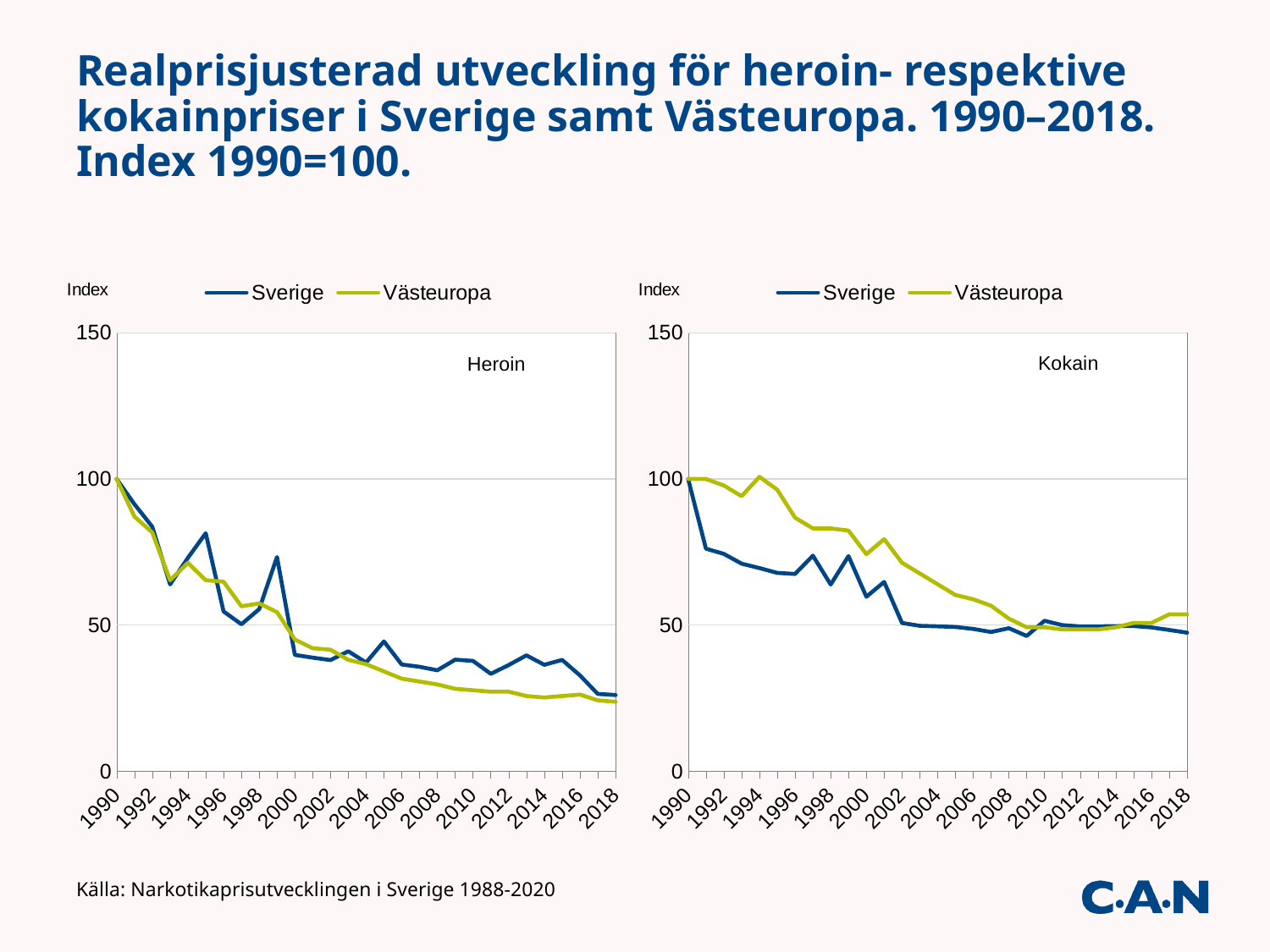
In the Heroin chart, in which year does the Sverige series reach its highest value? 1990 How many series does the legend of the Kokain chart list? 2 In the Heroin chart, does the Västeuropa line rise or fall from 1990 to 2018? fall In the Kokain chart, is the value for Sverige in 1991 greater or less than 100? less In the Kokain chart, which series has the higher value in 1994, Sverige or Västeuropa? Västeuropa In the Heroin chart, is the value for Sverige in 2018 greater or less than 50? less In the Kokain chart, is the value for Västeuropa in 2006 greater or less than 50? greater What kind of chart is the Heroin chart on the left? line chart In the Heroin chart, what is the index value for Sverige in 1990? 100 Which two series are listed in the legend of the Heroin chart? Sverige and Västeuropa In the Kokain chart, what is the index value for Västeuropa in 1990? 100